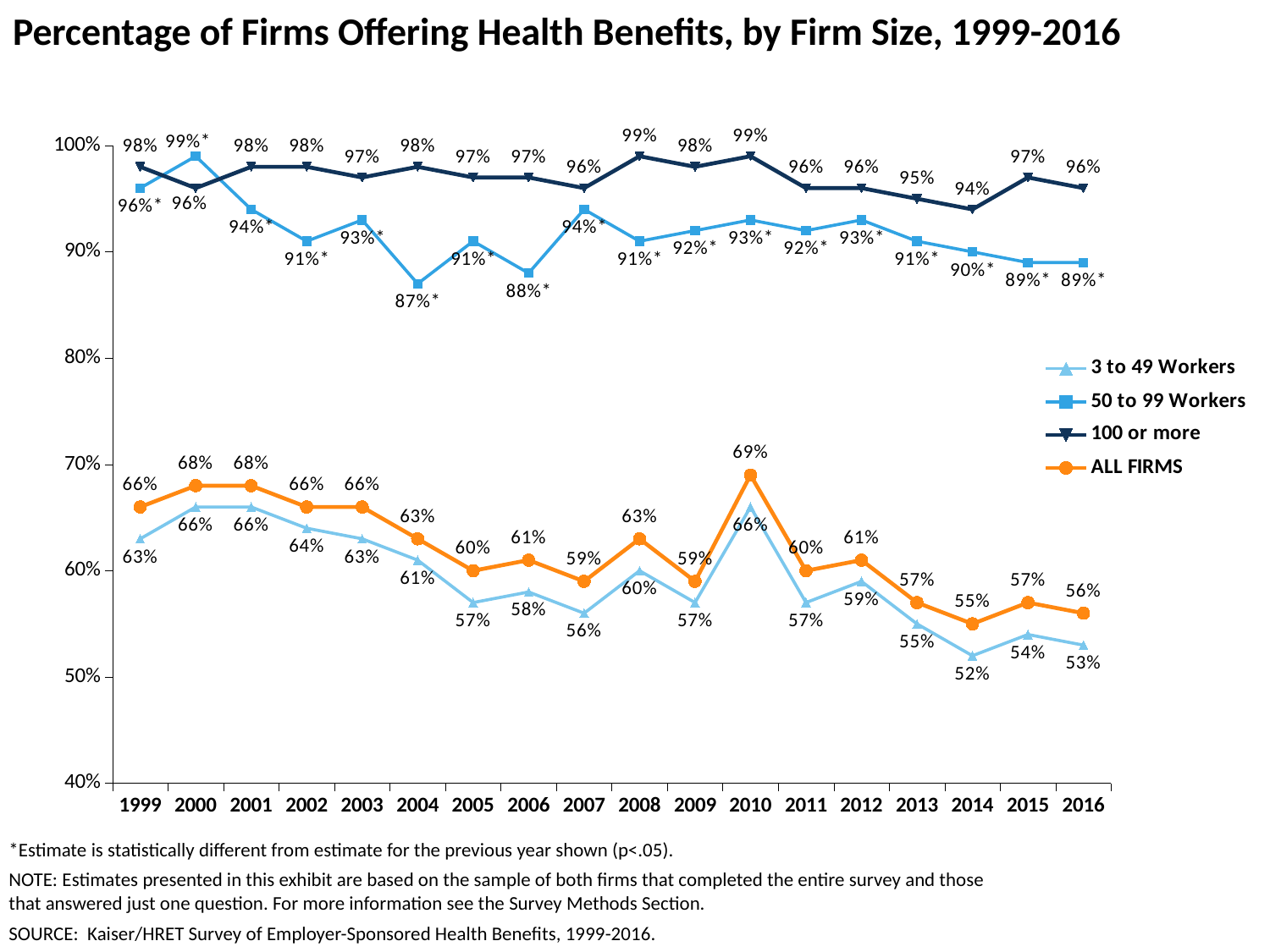
What is the value for firms with 3 to 49 workers in 2014? 52% Is the value for all firms in 2014 greater or less than 60%? less In which year was the percentage for firms with 3 to 49 workers lowest? 2014 In which year was the percentage for all firms highest? 2010 What is the value for firms with 50 to 99 workers in 2004? 87%* What percentage of all firms offered health benefits in 2010? 69% Which was larger in 2000: the value for 50 to 99 workers or the value for 100 or more workers? 50 to 99 Workers How many years are shown on the x axis? 18 What kind of chart is shown on the slide? Line chart What is the difference between the 100 or more workers value and the 3 to 49 workers value in 2016? 43 percentage points How many series does the legend list? 4 What is the value for firms with 100 or more workers in 2016? 96%